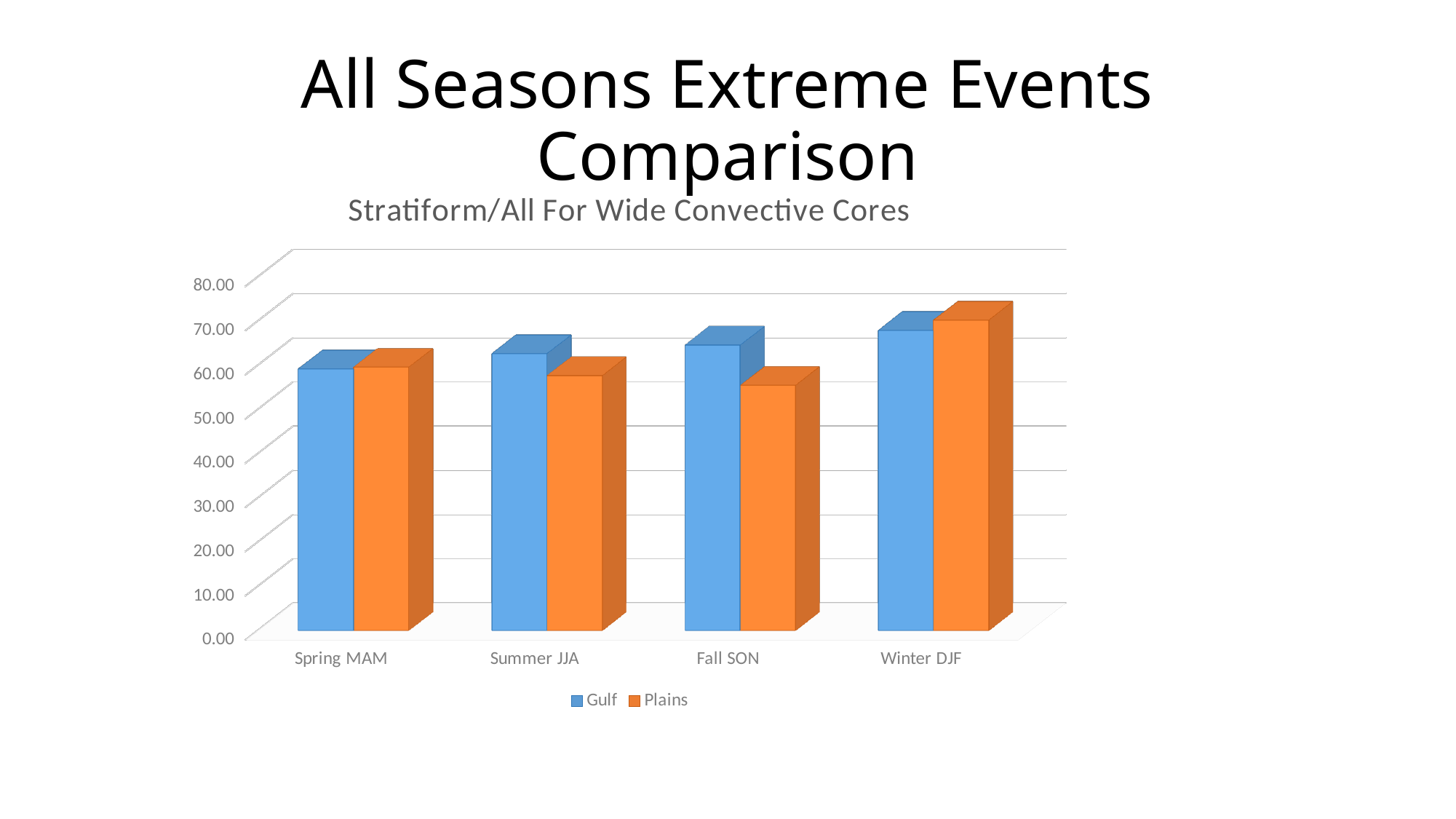
Which season has the highest Gulf value? Winter DJF Do the Gulf values rise or fall from Spring MAM to Winter DJF? rise What are the two series named in the legend? Gulf and Plains For Fall SON, which is larger, Gulf or Plains? Gulf For Summer JJA, which is larger, Gulf or Plains? Gulf Which season has the lowest Gulf value? Spring MAM Which season has the highest Plains value? Winter DJF How many series does the legend list? 2 How many seasons (categories) are shown on the x axis? 4 Is the Plains value for Fall SON greater or less than 60.00? less What kind of chart is shown on the slide? bar chart What is the title of the chart? Stratiform/All For Wide Convective Cores